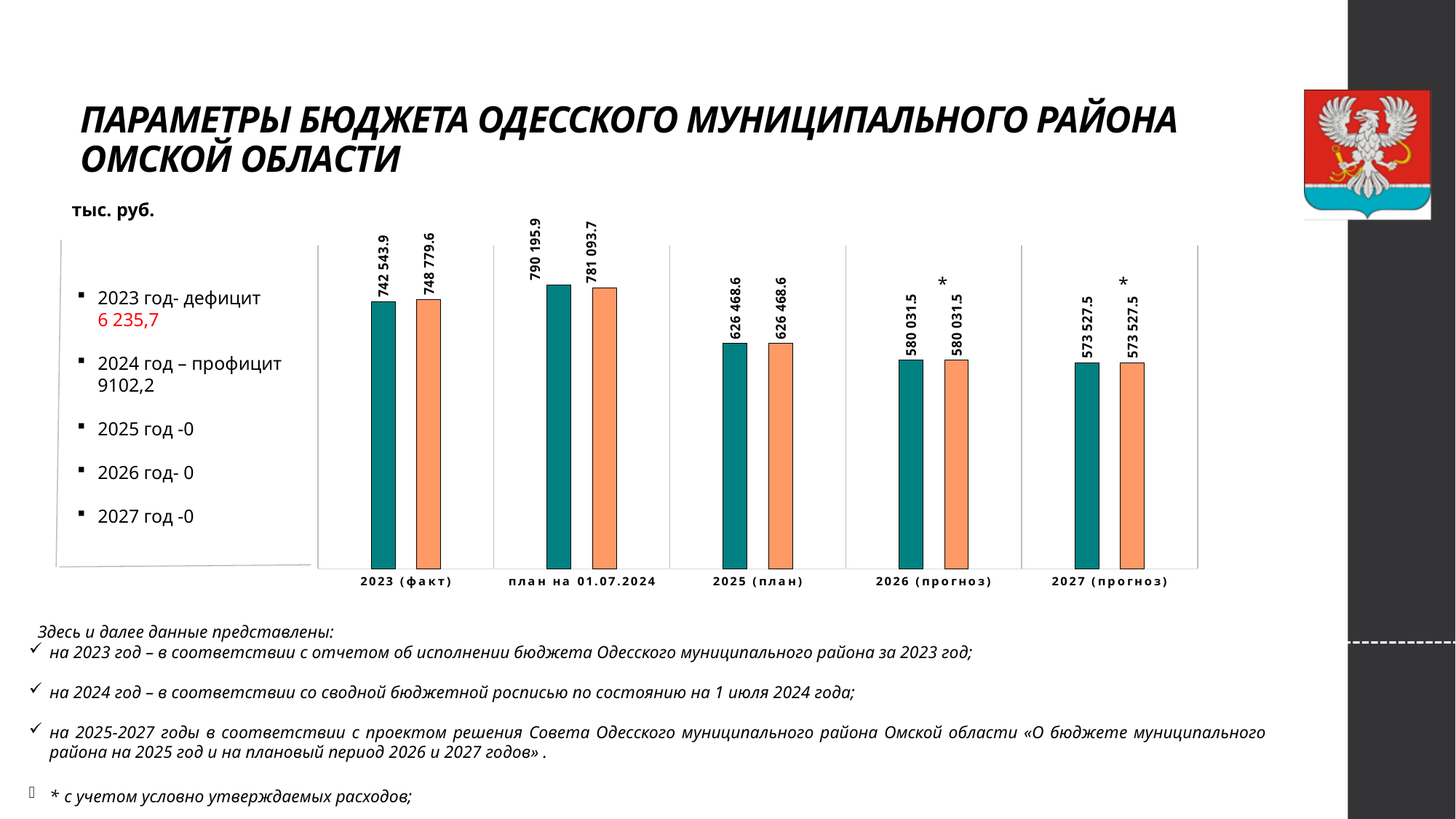
Which category has the lowest orange bar? 2027 (прогноз) Which category has the highest teal bar? план на 01.07.2024 What is the value of the orange bar for 2025 (план)? 626 468.6 What is the value of the orange bar for 2023 (факт)? 748 779.6 For план на 01.07.2024, which bar is larger, the teal one or the orange one? teal What is the value of the teal bar for 2023 (факт)? 742 543.9 What is the value of the teal bar for план на 01.07.2024? 790 195.9 What type of chart is shown on the slide? bar chart How many categories are shown along the x axis of the chart? 5 What is the difference between the orange bar and the teal bar for 2023 (факт)? 6 235.7 Do the teal bar values rise or fall from план на 01.07.2024 to 2027 (прогноз)? fall What is the value of the teal bar for 2027 (прогноз)? 573 527.5